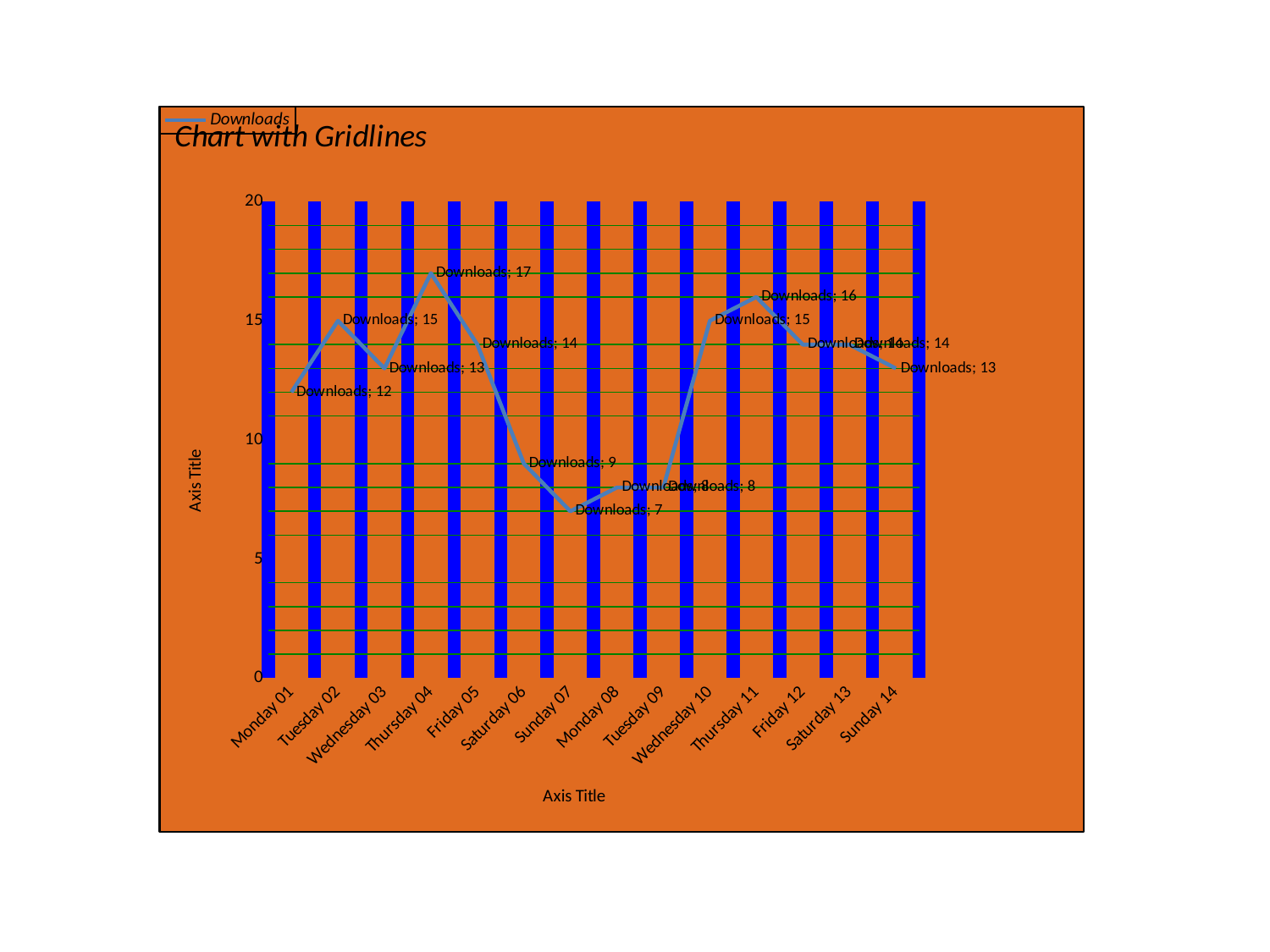
What kind of chart is shown on the slide? Line chart How many series does the legend list? 1 Which day has the lowest Downloads value? Sunday 07 Which has a larger Downloads value, Tuesday 02 or Wednesday 03? Tuesday 02 Which day has the highest Downloads value? Thursday 04 What is the Downloads value for Sunday 07? 7 What is the difference between the Downloads values for Thursday 04 and Sunday 07? 10 What is the title of the chart? Chart with Gridlines What is the Downloads value for Wednesday 10? 15 Do the Downloads values rise or fall from Thursday 04 to Sunday 07? Fall How many days are plotted on the x axis? 14 What is the Downloads value for Thursday 04? 17